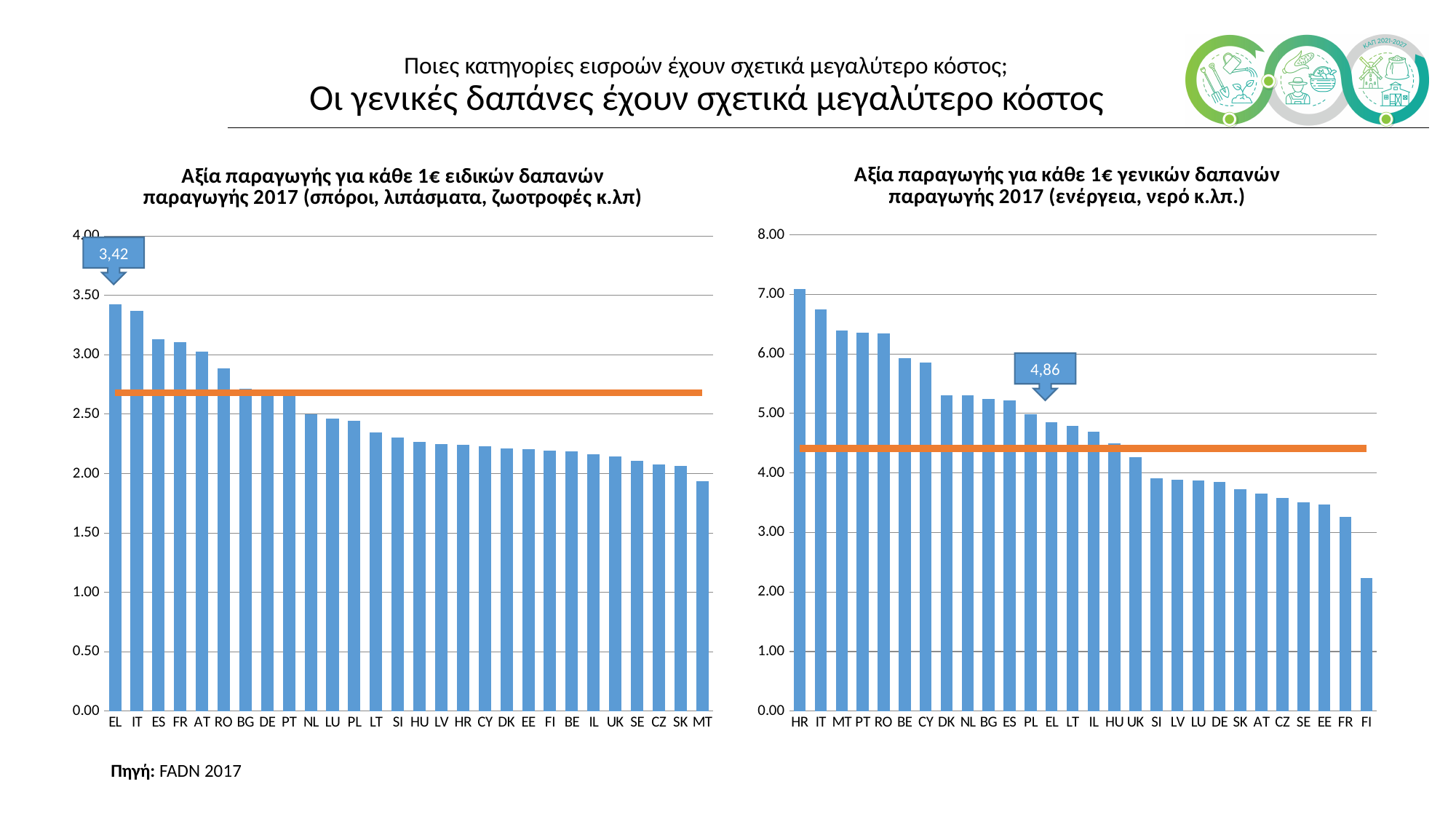
In the left chart (ειδικών δαπανών), is the value for MT greater or less than 2.00? less What kind of chart is the left chart (ειδικών δαπανών)? Bar chart In the left chart (ειδικών δαπανών), what value is shown in the callout for EL? 3,42 In the right chart (γενικών δαπανών), which country has the highest value? HR In the right chart (γενικών δαπανών), is the value for IT greater or less than 7.00? less In the left chart (ειδικών δαπανών), which is larger, the value for IT or the value for ES? IT In the right chart (γενικών δαπανών), what value is shown in the callout for EL? 4,86 In the left chart (ειδικών δαπανών), which country has the lowest value? MT In the right chart (γενικών δαπανών), do the values rise or fall from left to right along the x axis? Fall In the left chart (ειδικών δαπανών), which country has the highest value? EL How many countries are shown on the x axis of the right chart (γενικών δαπανών)? 28 In the right chart (γενικών δαπανών), which country has the lowest value? FI